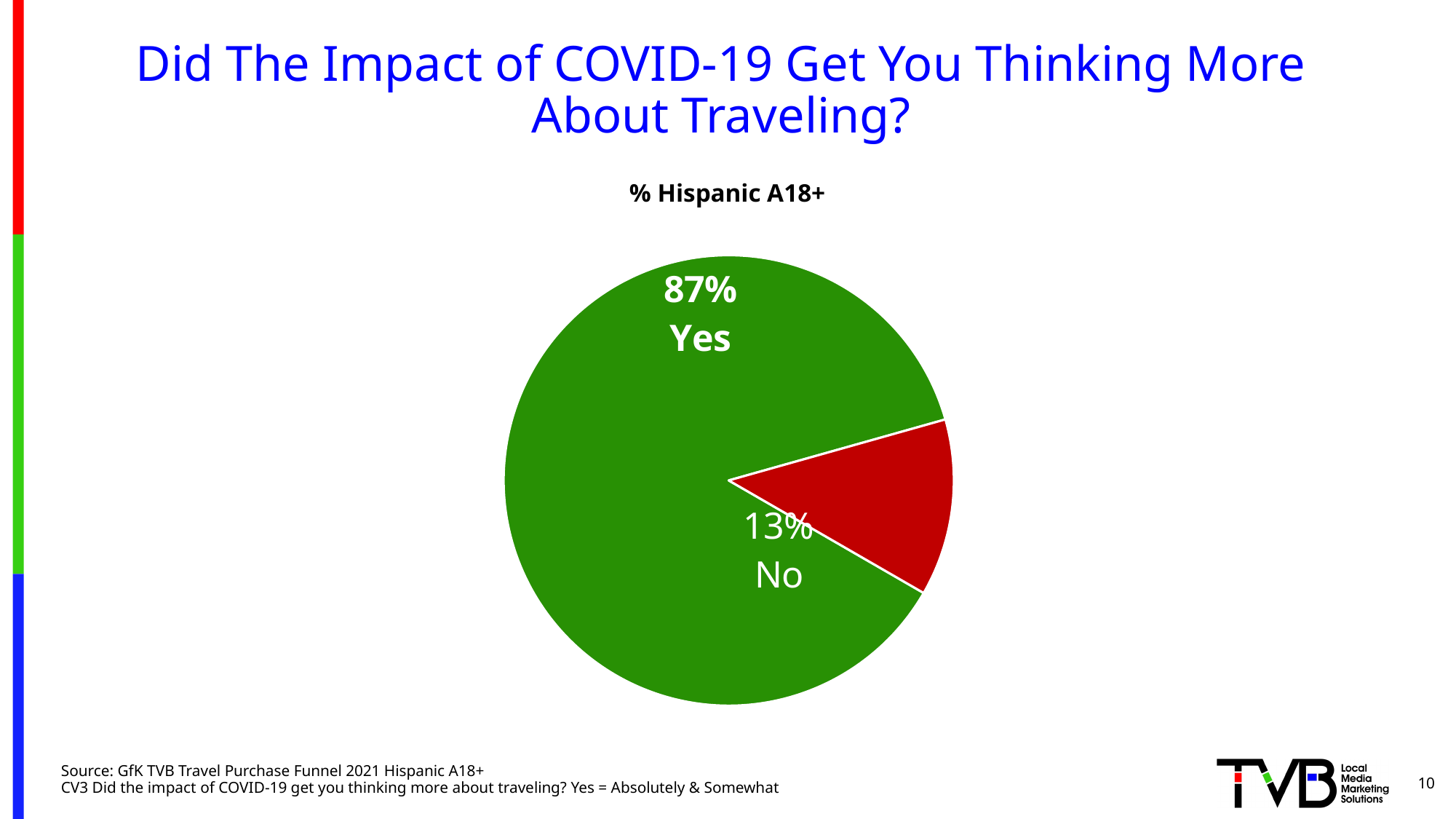
What is the difference in percentage points between the Yes and No slices? 74 What colour is the Yes slice of the pie chart? green What percentage of Hispanic adults 18+ answered Yes? 87% What share of the pie does the No slice represent? 13% Which response has the smallest share of the pie? No Which response has the largest share of the pie? Yes What is the subtitle shown above the pie chart? % Hispanic A18+ What kind of chart is shown on the slide? pie chart Which slice is larger, Yes or No? Yes What percentage of Hispanic adults 18+ answered No? 13% How many slices does the pie chart have? 2